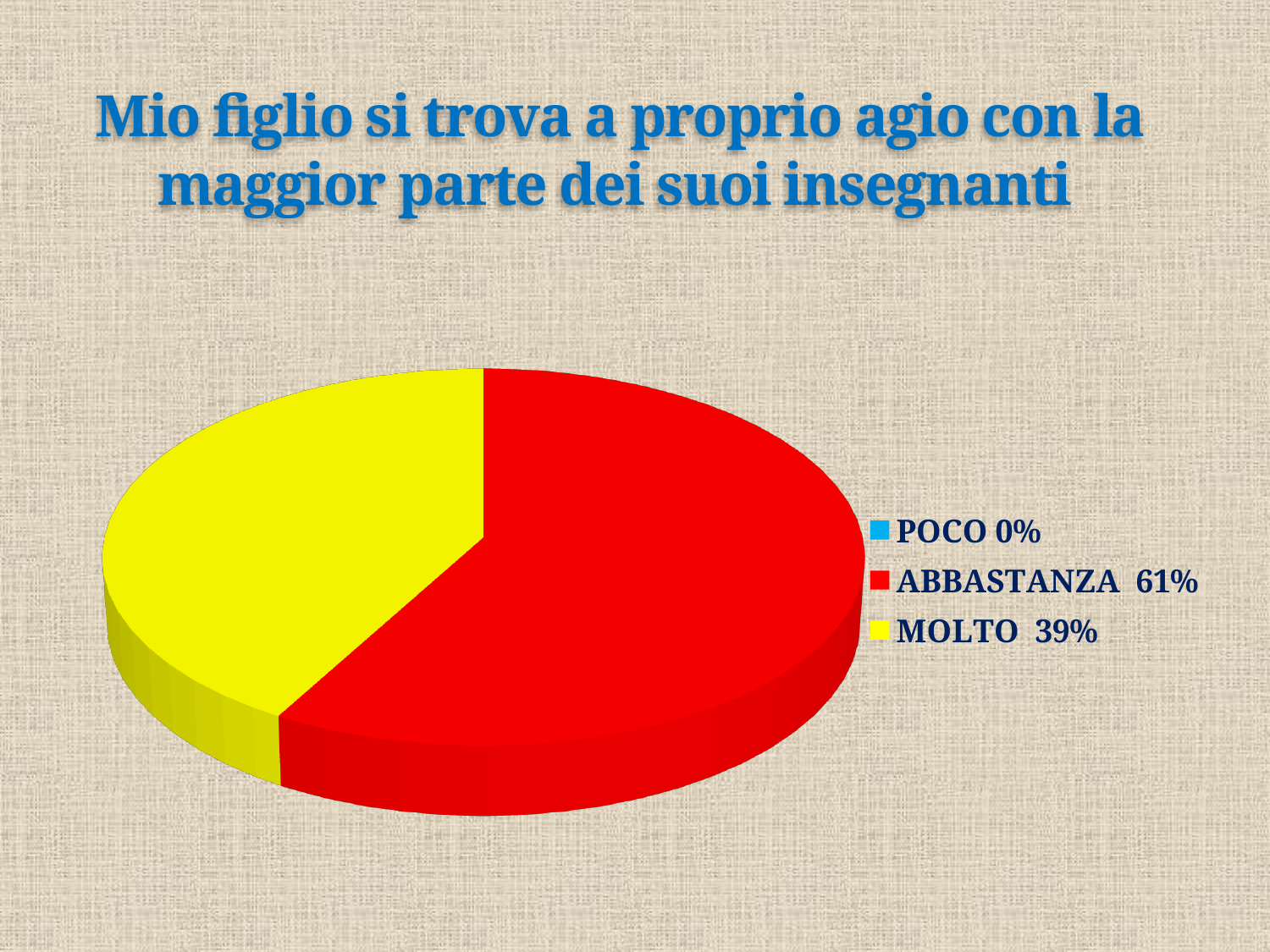
Which is larger, the share for MOLTO or the share for ABBASTANZA? ABBASTANZA Which category has the smallest share according to the legend? POCO What share of the pie does ABBASTANZA represent? 61% Is the share for MOLTO greater or less than 50%? less What percentage is shown for POCO in the legend? 0% What kind of chart is shown on the slide? pie chart What is the difference in percentage points between ABBASTANZA and MOLTO? 22 What is the title of the slide? Mio figlio si trova a proprio agio con la maggior parte dei suoi insegnanti How many categories does the legend list? 3 What colour represents ABBASTANZA in the chart? red What share of the pie does MOLTO represent? 39% Which category has the largest share of the pie? ABBASTANZA